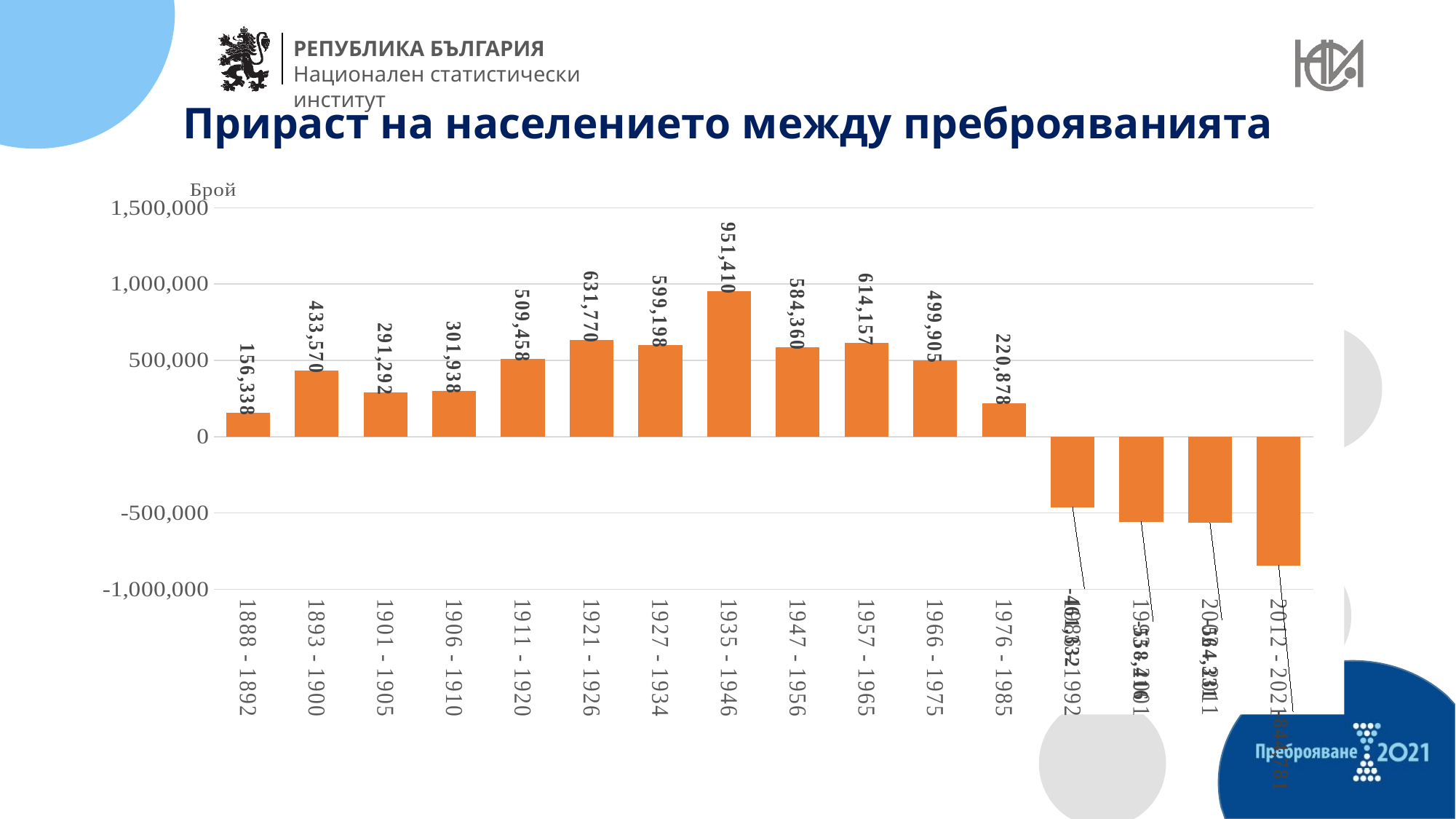
What is the value for 1935 - 1946? 951,410 Which period has the highest value? 1935 - 1946 What is the difference between the values for 1893 - 1900 and 1888 - 1892? 277,232 How many periods are shown on the x axis? 16 Is the value for 2012 - 2021 greater or less than -500,000? less What kind of chart is shown on the slide? bar chart What is the value for 1976 - 1985? 220,878 Which period has the lowest value? 2012 - 2021 What is the label on the vertical axis? Брой Which is larger, the value for 1921 - 1926 or for 1927 - 1934? 1921 - 1926 What is the difference between the values for 1935 - 1946 and 1921 - 1926? 319,640 What is the value for 1888 - 1892? 156,338